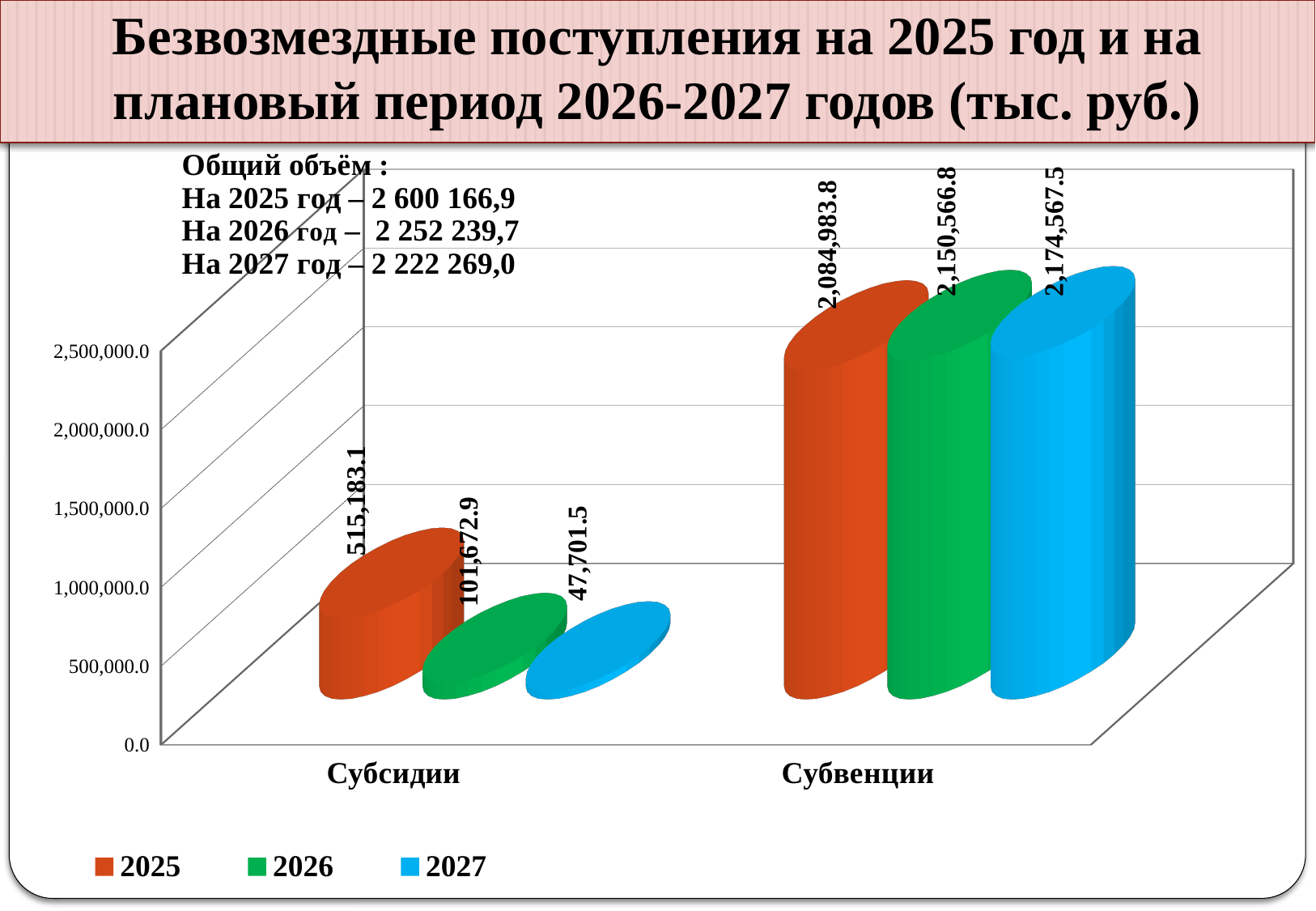
What is the value for Субсидии in 2025? 515,183.1 Which is larger: Субвенции in 2025 or Субвенции in 2026? Субвенции in 2026 What is the value for Субсидии in 2027? 47,701.5 Do the values for Субсидии rise or fall from 2025 to 2027? Fall What is the difference between the 2025 and 2026 values for Субсидии? 413,510.2 How many series does the legend list? 3 Which year has the lowest value for Субсидии? 2027 What is the value for Субвенции in 2026? 2,150,566.8 Which year has the highest value for Субвенции? 2027 What kind of chart is shown on the slide? Bar chart How many categories are shown on the x axis? 2 What is the value for Субвенции in 2027? 2,174,567.5